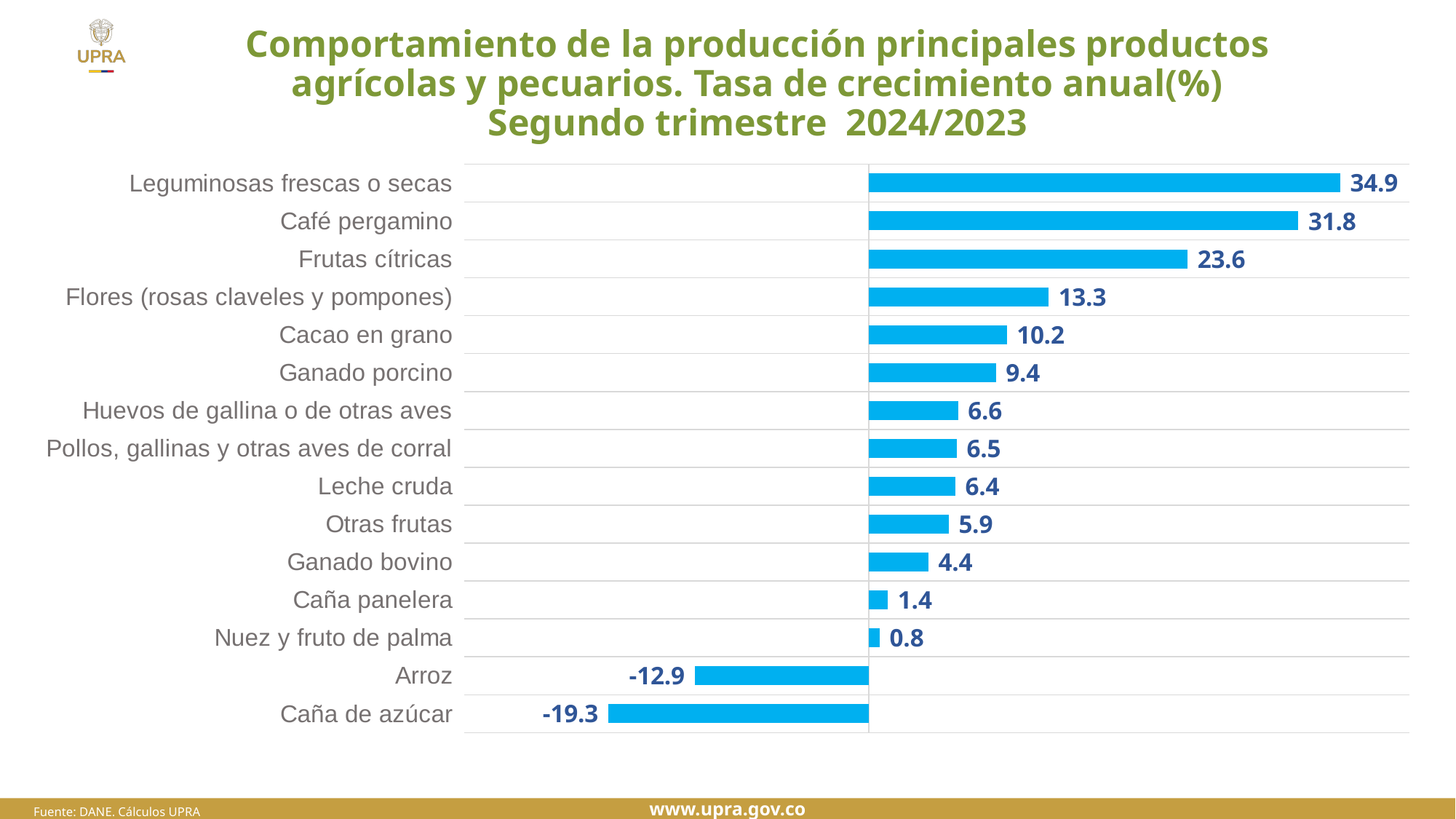
Which product has the highest growth rate on the chart? Leguminosas frescas o secas Which product has the lowest growth rate on the chart? Caña de azúcar What is the difference between the values for Leguminosas frescas o secas and Café pergamino? 3.1 How many products on the chart have a negative growth rate? 2 What kind of chart is shown on the slide? Bar chart What is the value shown for Arroz? -12.9 What is the value shown for Ganado porcino? 9.4 What is the difference between the values for Frutas cítricas and Flores (rosas claveles y pompones)? 10.3 Which has a larger value, Cacao en grano or Ganado bovino? Cacao en grano What is the annual growth rate shown for Café pergamino? 31.8 Which has a larger value, Caña panelera or Nuez y fruto de palma? Caña panelera How many products are shown on the chart? 15